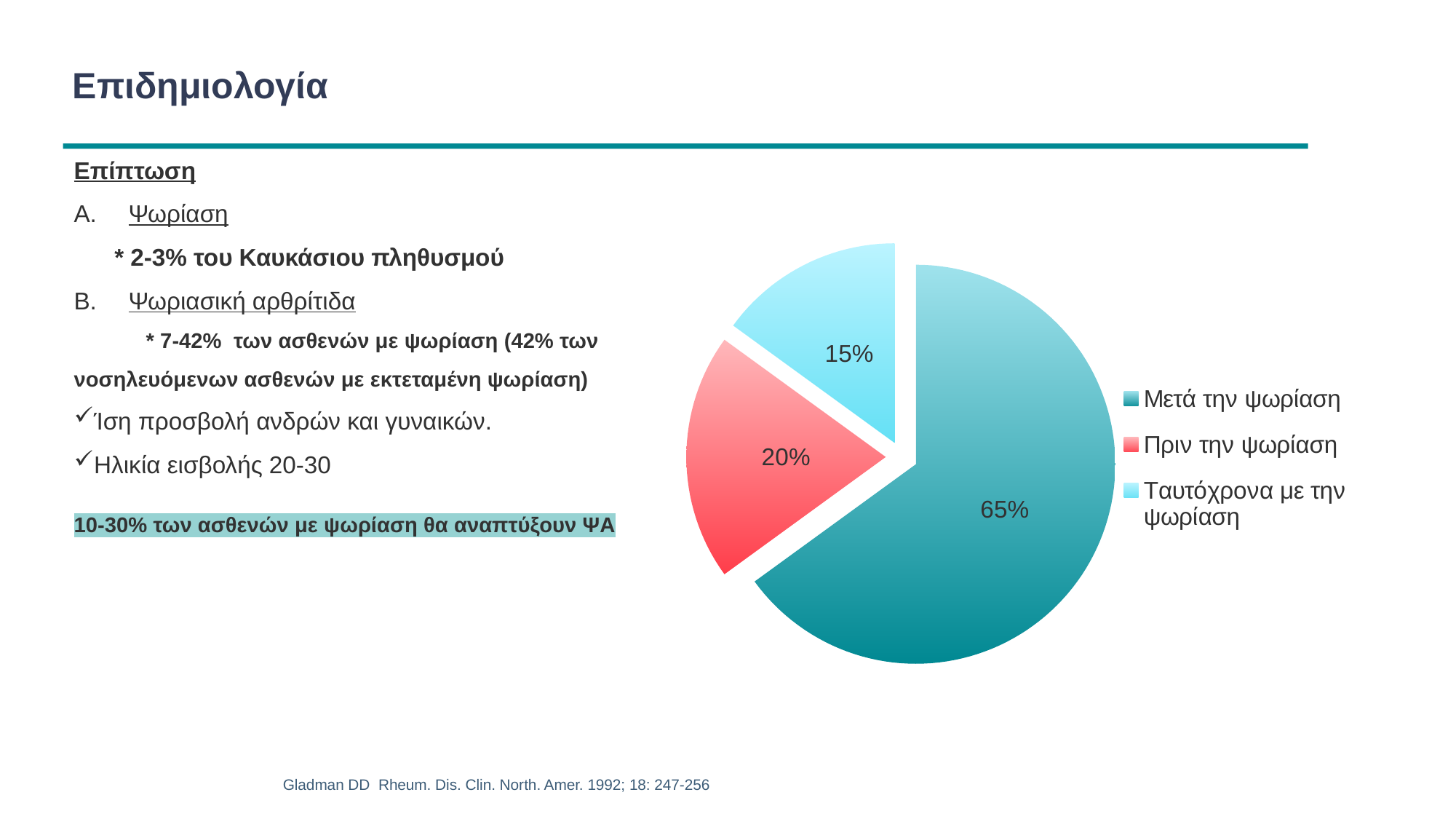
How many entries does the legend of the pie chart list? 3 Which is larger: the 'Πριν την ψωρίαση' slice or the 'Ταυτόχρονα με την ψωρίαση' slice? Πριν την ψωρίαση What percentage is shown for the slice 'Πριν την ψωρίαση'? 20% Which slice of the pie chart is the smallest? Ταυτόχρονα με την ψωρίαση What is the combined share of the 'Πριν την ψωρίαση' and 'Ταυτόχρονα με την ψωρίαση' slices? 35% What kind of chart is shown on the slide? pie chart What percentage is shown for the slice 'Ταυτόχρονα με την ψωρίαση'? 15% What is the difference between the 'Μετά την ψωρίαση' slice and the 'Πριν την ψωρίαση' slice? 45% How many slices does the pie chart have? 3 Which slice of the pie chart is the largest? Μετά την ψωρίαση What percentage is shown for the slice 'Μετά την ψωρίαση'? 65% What colour is the 'Πριν την ψωρίαση' slice in the pie chart? red